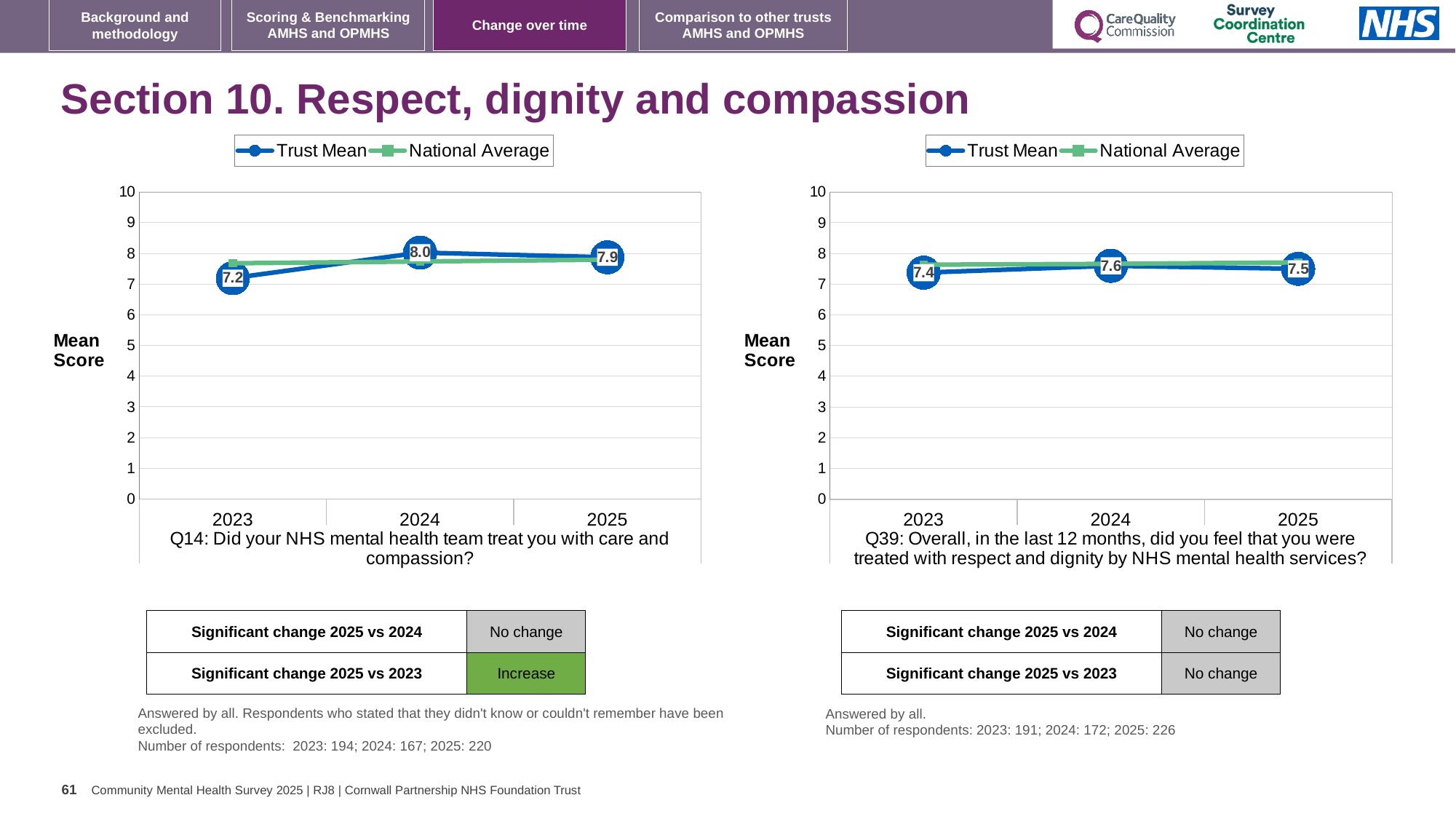
In the Q14 chart (left), what is the Trust Mean score for 2023? 7.2 In the Q39 chart (right), is the Trust Mean score for 2024 greater or less than 7? greater In the Q14 chart (left), which year has the lowest Trust Mean score? 2023 How many years are shown on the x axis of the Q39 chart (right)? 3 In the Q14 chart (left), what is the difference between the Trust Mean scores for 2024 and 2023? 0.8 In the Q14 chart (left), what is the Trust Mean score for 2024? 8.0 How many series does the legend of the Q14 chart (left) list? 2 In the Q14 chart (left), which year has the highest Trust Mean score? 2024 In the Q39 chart (right), what is the Trust Mean score for 2025? 7.5 In the Q39 chart (right), what is the Trust Mean score for 2023? 7.4 In the Q14 chart (left), is the Trust Mean for 2025 higher or lower than the Trust Mean for 2023? higher What type of chart is used for Q39 (right)? Line chart